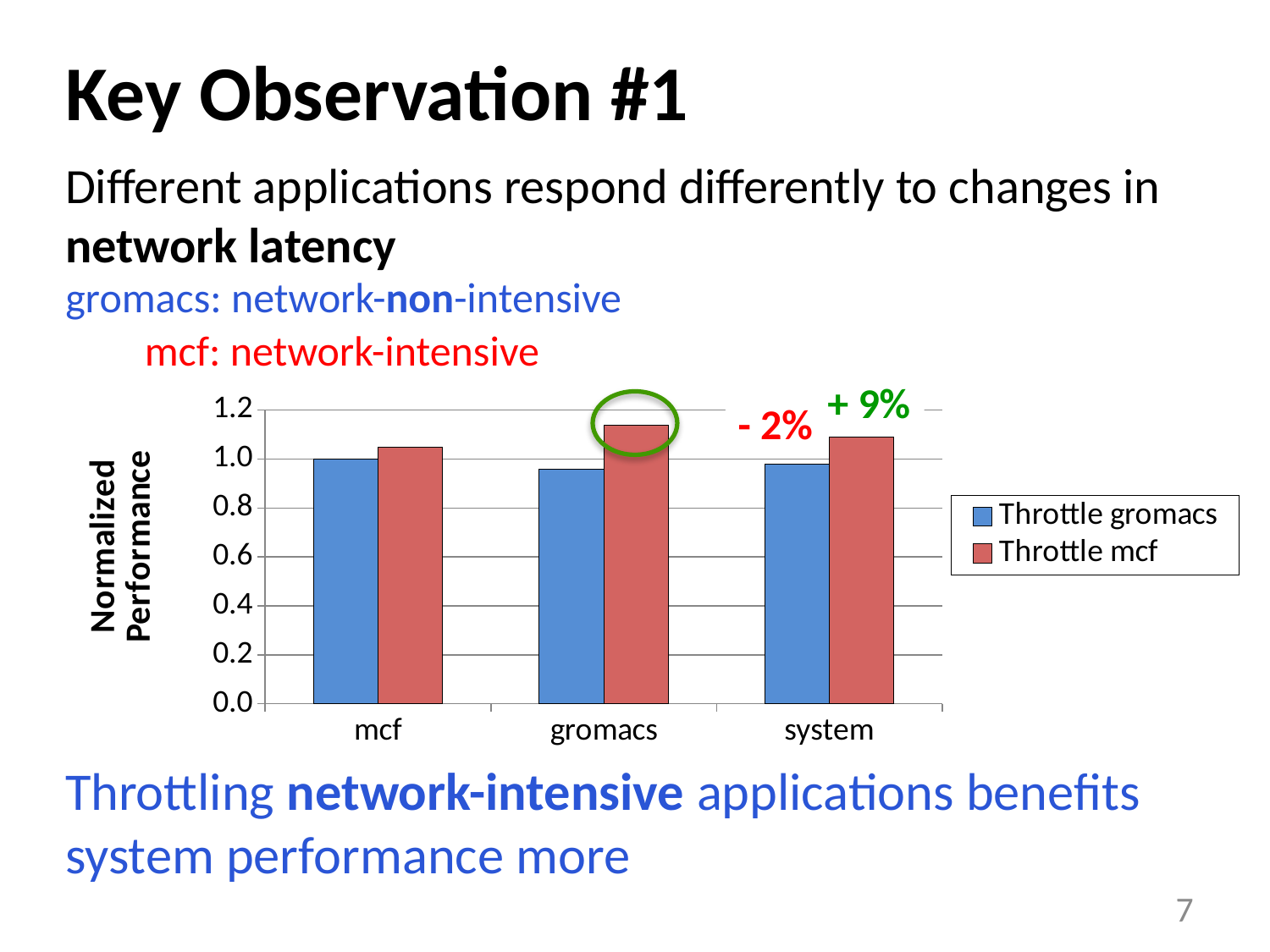
How many categories are shown on the x axis of the chart? 3 What are the two series listed in the chart legend? Throttle gromacs, Throttle mcf Which category has the highest Throttle mcf value? gromacs Is the Throttle mcf value for system greater or less than 1.0? greater For gromacs, which series has the larger value, Throttle gromacs or Throttle mcf? Throttle mcf Is the Throttle gromacs value for gromacs greater or less than 1.0? less How many series does the chart legend list? 2 What percentage change is annotated above the Throttle mcf bar for system? + 9% What is the Throttle gromacs value for mcf? 1.0 What kind of chart is shown on the slide? bar chart What is the y-axis title of the chart? Normalized Performance Is the Throttle mcf value for gromacs greater or less than 1.0? greater